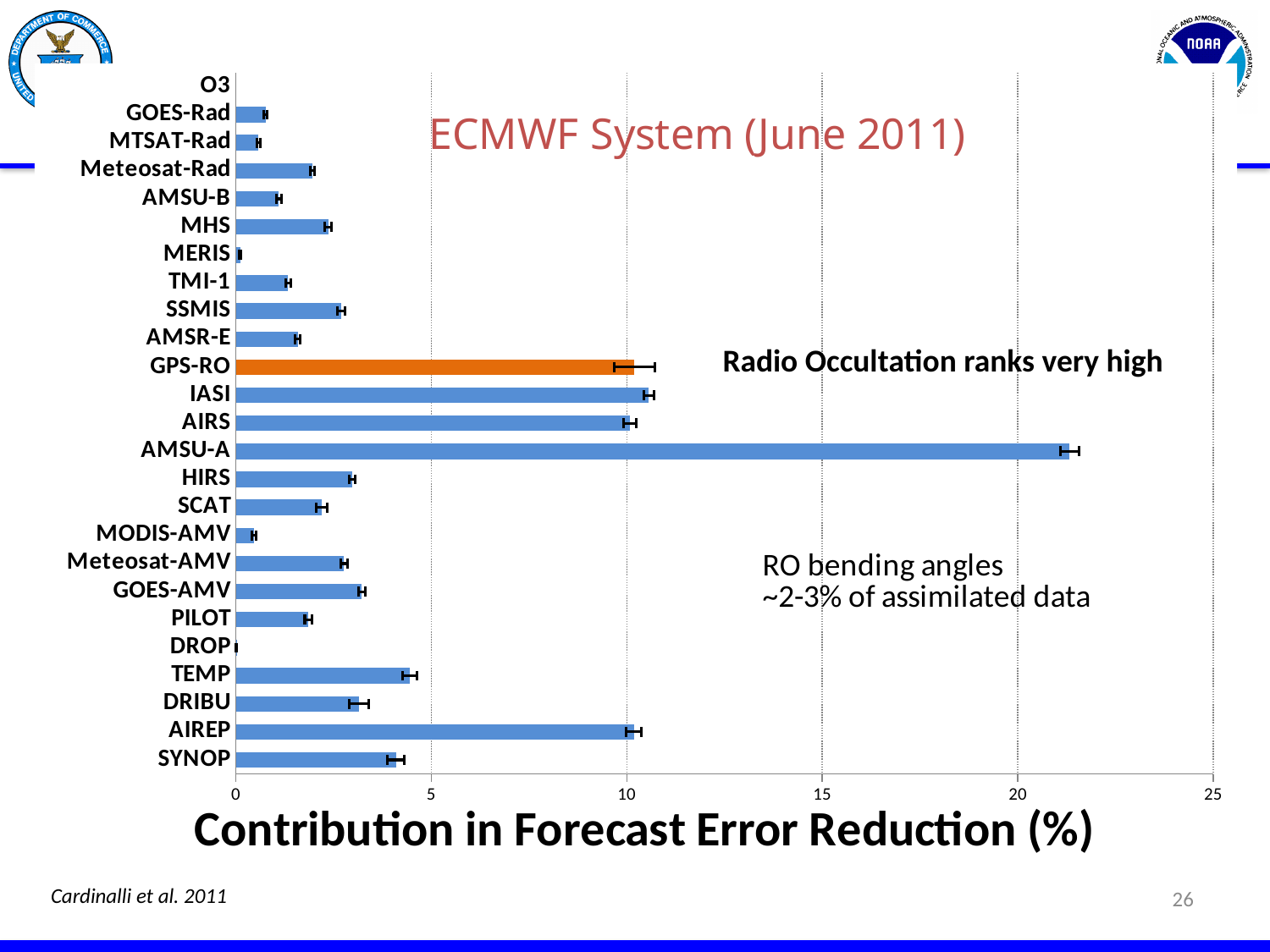
Is the value for HIRS greater or less than 5? less How many categories are plotted on the chart? 25 Is the value for TEMP greater or less than 5? less Is the value for AMSU-A greater or less than 20? greater Which has a larger value, GOES-AMV or PILOT? GOES-AMV What kind of chart is shown on the slide? bar chart Which category has the highest contribution in forecast error reduction? AMSU-A What is the title of the chart? ECMWF System (June 2011) Which has a larger value, GPS-RO or HIRS? GPS-RO Which category's bar is highlighted in orange? GPS-RO